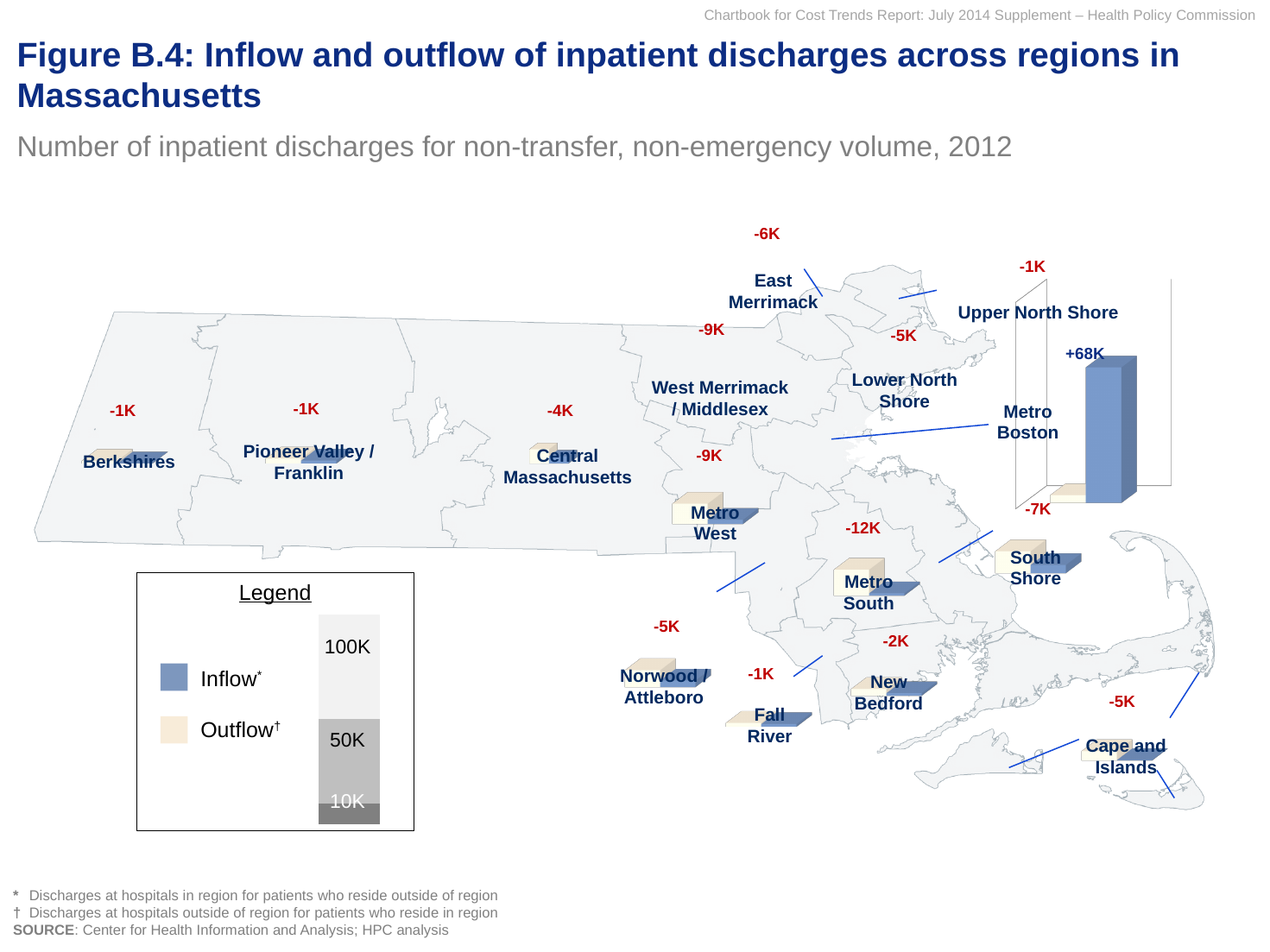
What is the net value shown for Central Massachusetts? -4K Which region has the highest net value labeled on the map? Metro Boston What is the net value shown for Metro Boston? +68K How many regions have a net value labeled on the map? 15 What is the difference between the net values for Metro South and South Shore? 5K How many series does the legend list? 2 Which colour represents Inflow in the legend? Blue What is the net value shown for Cape and Islands? -5K What year of data does the subtitle say the chart shows? 2012 Which region has the larger net value, South Shore or Metro West? South Shore What is the net value shown for Metro South? -12K Which region has the lowest net value labeled on the map? Metro South